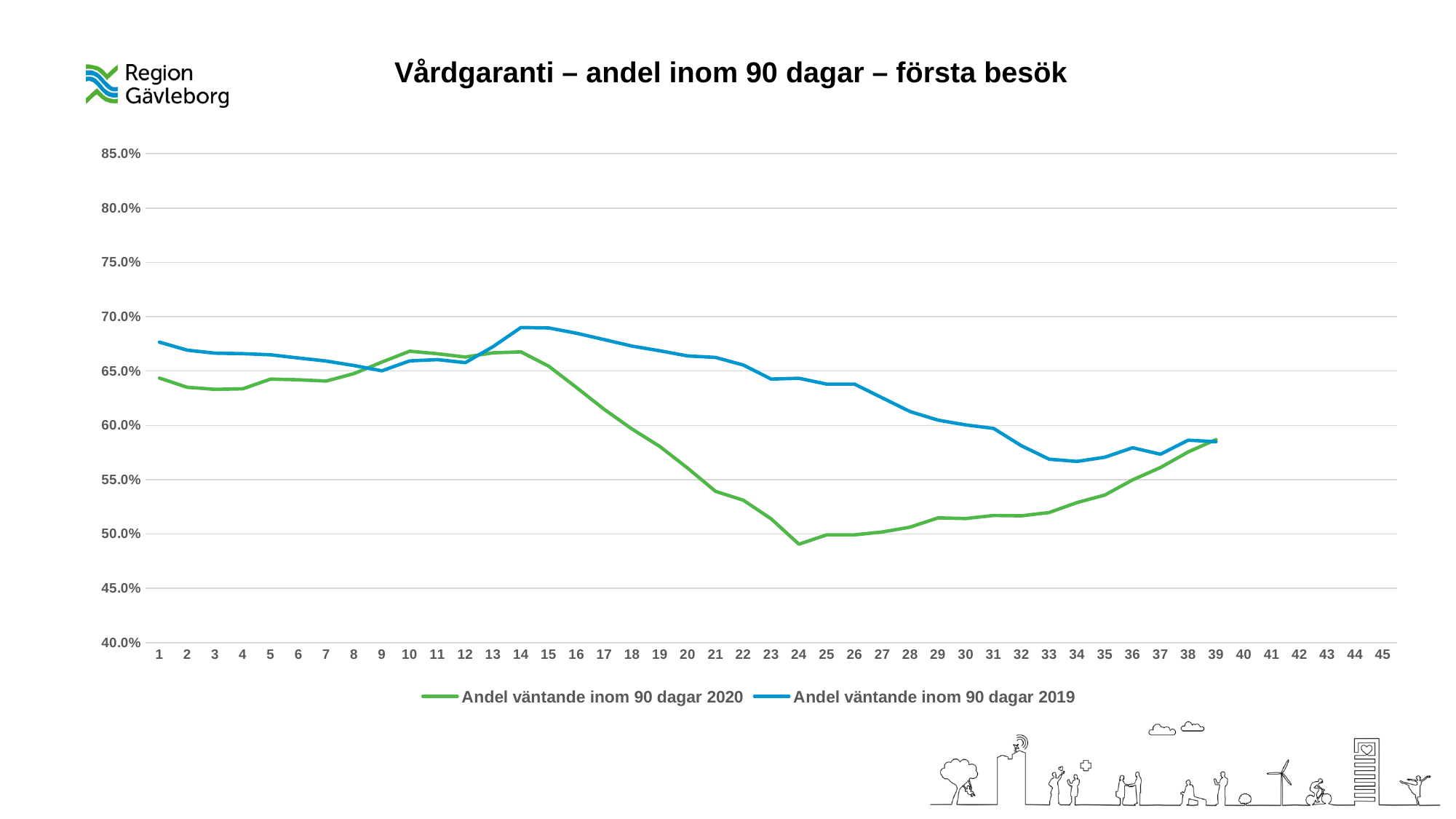
At point 24, which series has the higher value, 2020 or 2019? Andel väntande inom 90 dagar 2019 Does the series 'Andel väntande inom 90 dagar 2020' rise or fall between point 15 and point 24? fall At which point does the series 'Andel väntande inom 90 dagar 2020' reach its lowest value? 24 How many labels are shown on the x axis? 45 Is the value for 'Andel väntande inom 90 dagar 2019' at point 14 greater or less than 65.0%? greater What kind of chart is shown on the slide? line chart Is the value for 'Andel väntande inom 90 dagar 2020' at point 24 greater or less than 50.0%? less Is the value for 'Andel väntande inom 90 dagar 2020' at point 1 greater or less than 65.0%? less What is the title of the chart? Vårdgaranti – andel inom 90 dagar – första besök Which colour is used for the series 'Andel väntande inom 90 dagar 2019'? blue How many series does the legend list? 2